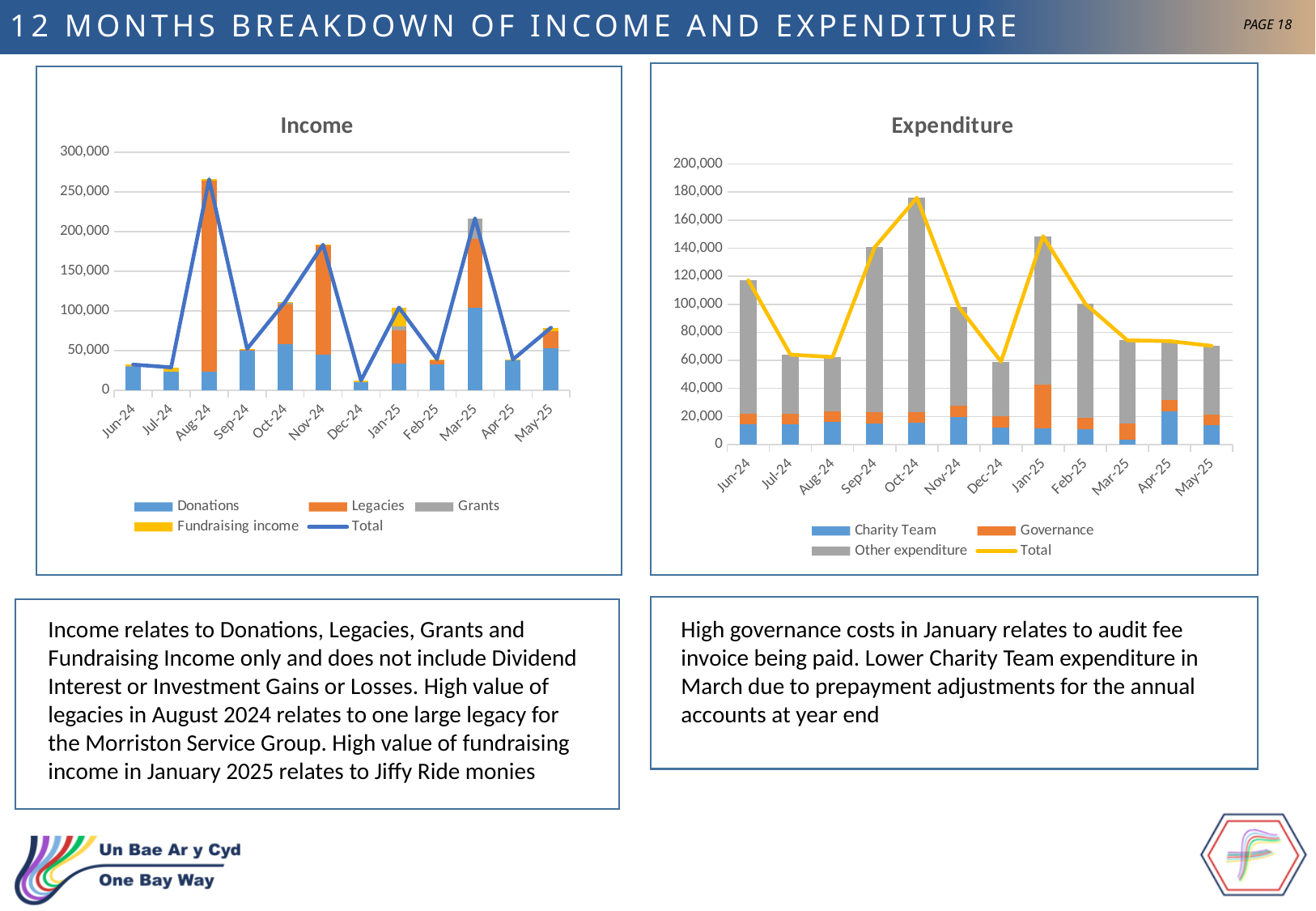
On the Income chart, which month has the highest total income? Aug-24 On the Expenditure chart, which month has the highest total expenditure? Oct-24 On the Expenditure chart, how many series does the legend list? 4 On the Income chart, how many series does the legend list? 5 On the Expenditure chart, which is larger, the total expenditure for Oct-24 or for Jan-25? Oct-24 On the Income chart, how many months are shown on the x axis? 12 On the Income chart, is the total income for Dec-24 greater or less than 50,000? less On the Income chart, is the total income for Aug-24 greater or less than 250,000? greater On the Expenditure chart, is the total expenditure for Oct-24 greater or less than 160,000? greater On the Income chart, which month has the lowest total income? Dec-24